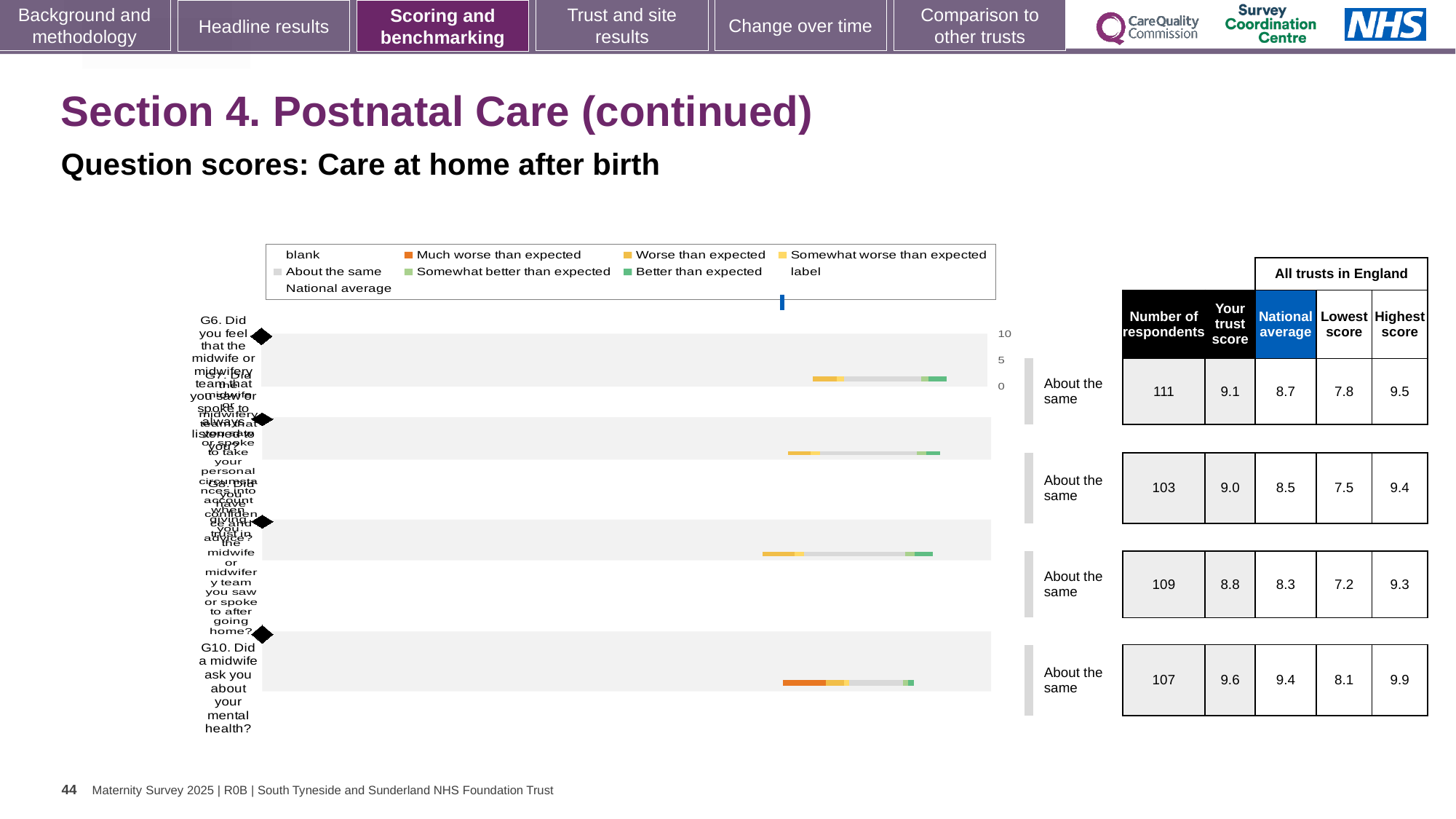
What is the national average for G10 (Did a midwife ask you about your mental health?)? 9.4 Which question has the highest 'Your trust score'? G10 What is the lowest score across all trusts in England for G10? 8.1 How many question bars are plotted in the chart? 4 What is the 'Your trust score' for G10 (Did a midwife ask you about your mental health?)? 9.6 What kind of chart is shown on the slide? bar chart What is the difference between the trust score and the national average for G10? 0.2 What is the highest score across all trusts in England for the first question, G6? 9.5 How many respondents are listed for the first question, G6? 111 Which legend entry is shown in orange? Much worse than expected For G10, which is larger: the trust score or the national average? the trust score Which legend entry is shown in grey? About the same